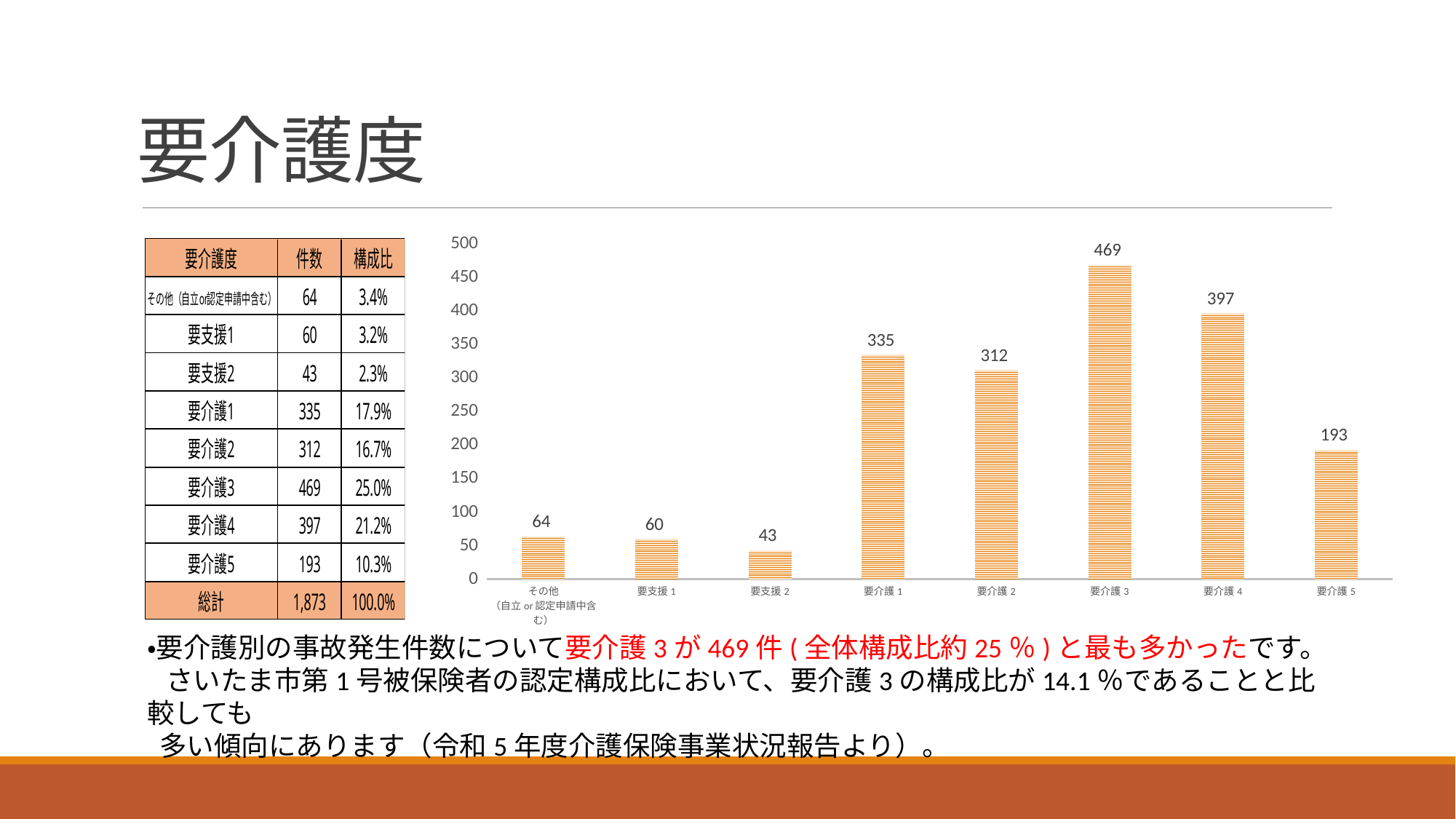
Which category has the highest value in the chart? 要介護3 Which is larger, the value for 要介護4 or the value for 要介護1? 要介護4 Which category has the lowest value in the chart? 要支援2 What is the difference between the values for 要介護1 and 要介護2? 23 What is the value for 要介護3 in the chart? 469 What is the value for 要介護5 in the chart? 193 What is the value for その他 (自立 or 認定申請中含む) in the chart? 64 What kind of chart is shown on the slide? bar chart What is the value for 要支援2 in the chart? 43 What is the difference between the values for 要介護3 and 要介護4? 72 Is the value for 要介護2 greater or less than 300? greater How many categories are shown in the chart? 8